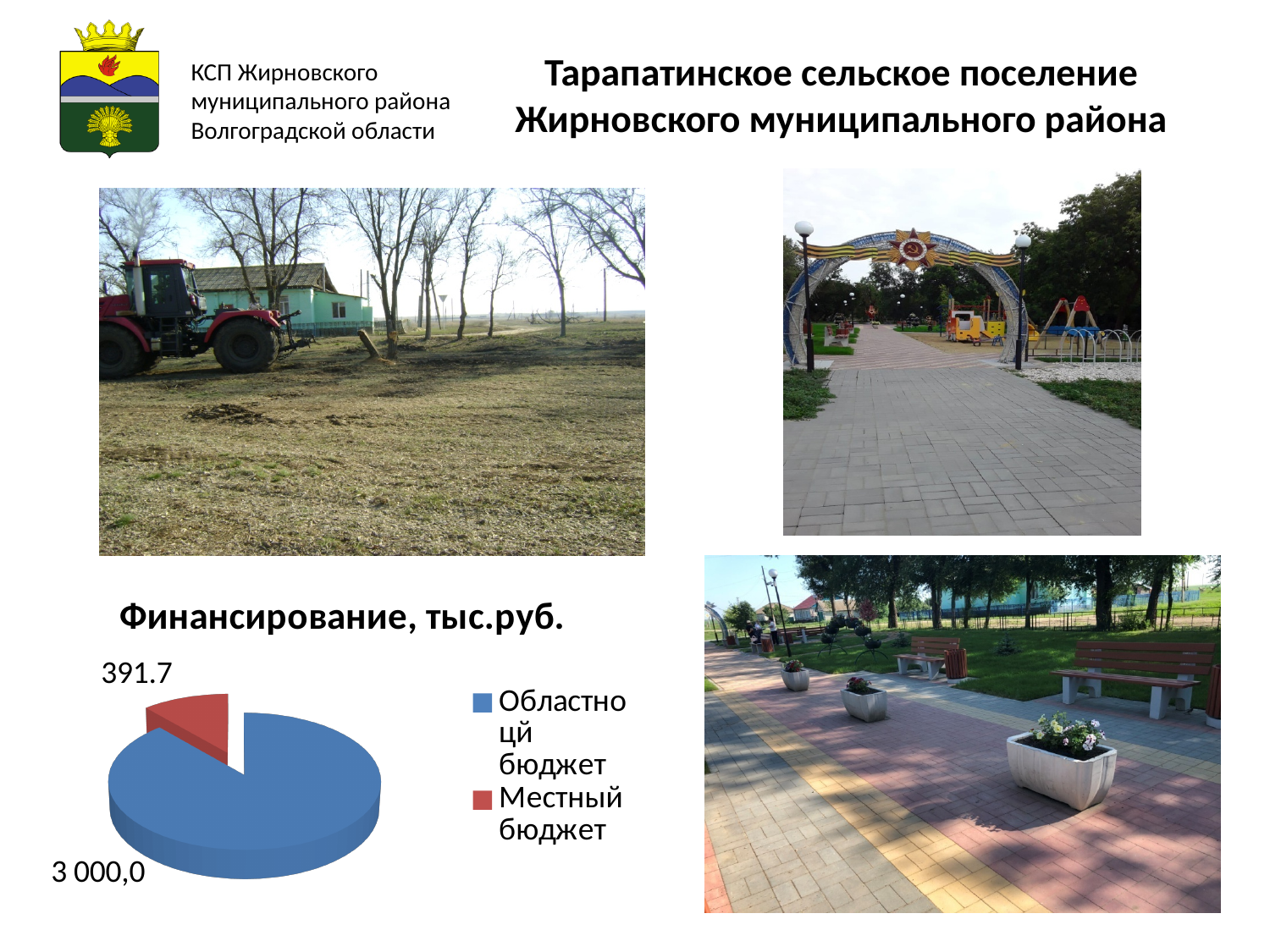
How many entries does the chart legend list? 2 What is the value for Областной бюджет in the pie chart? 3 000,0 Which is larger in the pie chart, Областной бюджет or Местный бюджет? Областной бюджет What colour is the slice for Местный бюджет in the pie chart? red What is the value for Местный бюджет in the pie chart? 391.7 What kind of chart is shown on the slide? pie chart Which budget source has the largest slice in the pie chart? Областной бюджет What is the total of the two values shown in the pie chart? 3391.7 How many slices does the pie chart have? 2 By how much does Областной бюджет exceed Местный бюджет in the pie chart? 2608.3 What is the title of the chart on the slide? Финансирование, тыс.руб. Which budget source has the smallest slice in the pie chart? Местный бюджет